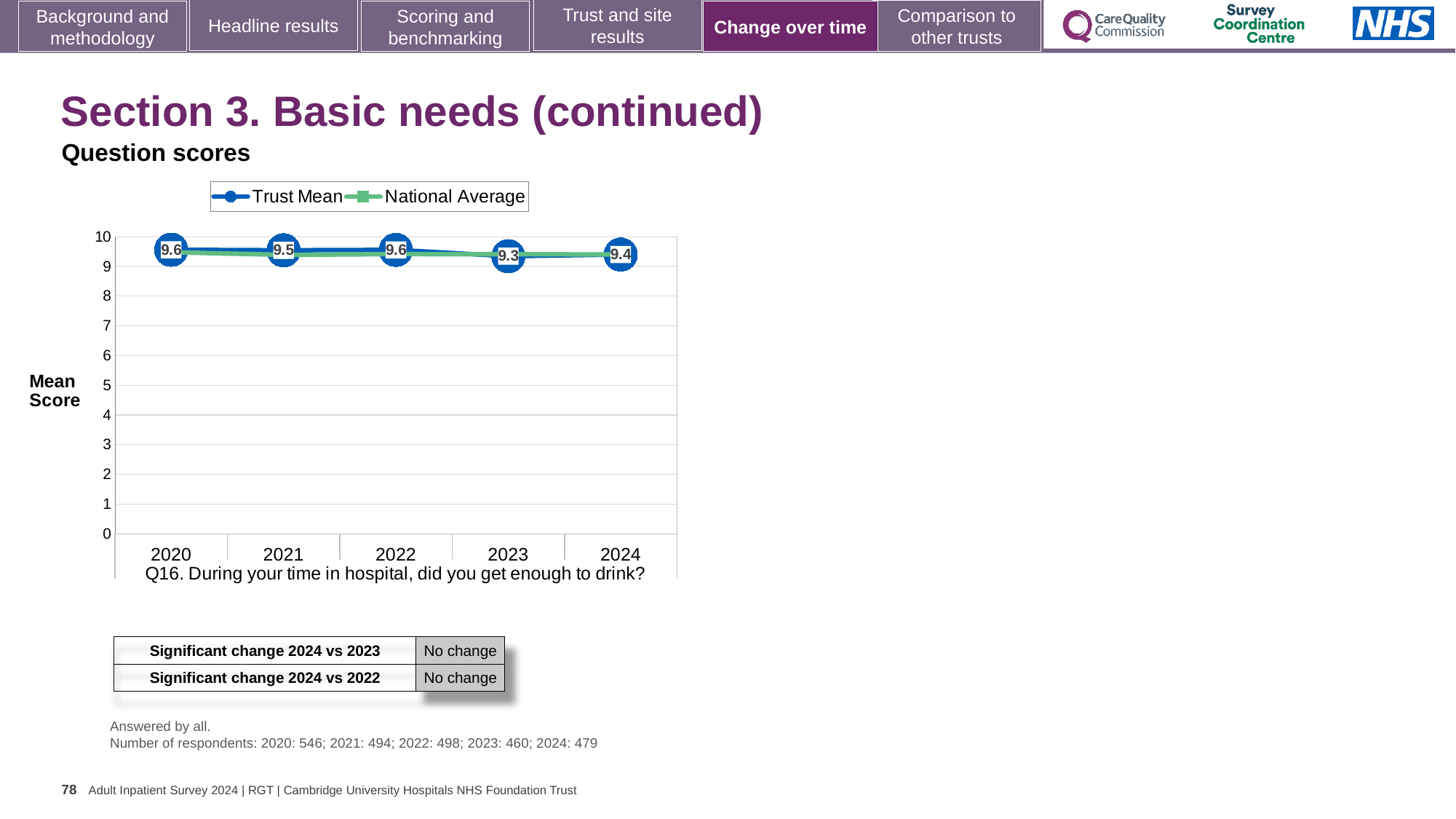
What is the Trust Mean score for 2024? 9.4 How many years are shown on the x axis? 5 What is the Trust Mean score for 2020? 9.6 What is the Trust Mean score for 2021? 9.5 What is the difference between the Trust Mean scores for 2022 and 2023? 0.3 In which year is the Trust Mean score lowest? 2023 Which year has the higher Trust Mean score, 2021 or 2023? 2021 How many series does the legend list? 2 What kind of chart is shown on the slide? line chart Is the National Average value for 2024 greater or less than 8? greater What is the Trust Mean score for 2023? 9.3 Does the Trust Mean score rise or fall from 2022 to 2023? fall